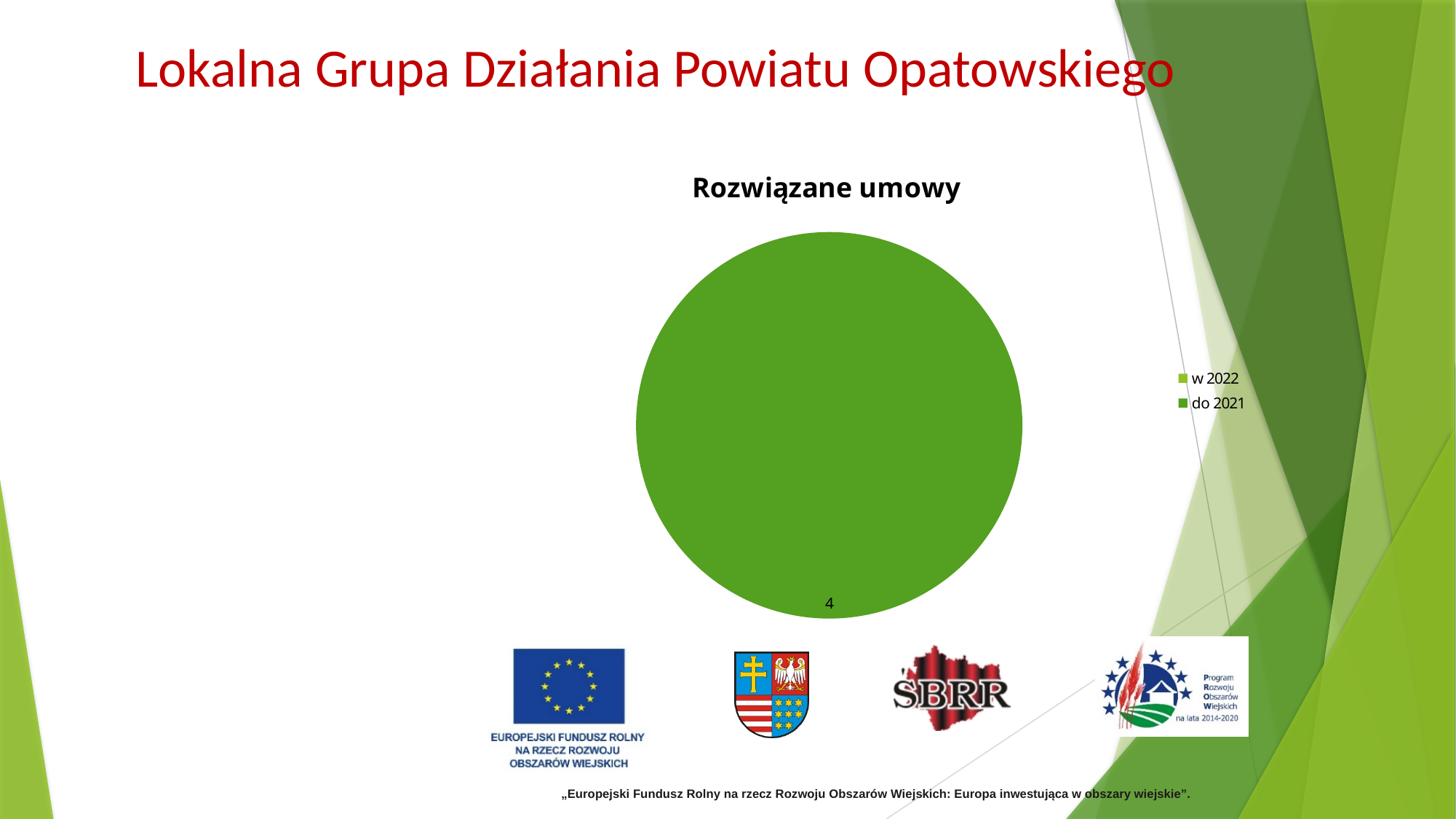
What value is printed as a data label on the pie chart? 4 How many entries does the chart legend list? 2 What kind of chart is shown on the slide? pie chart Is the value printed on the pie chart greater or less than 10? less What are the two entries listed in the chart legend? w 2022 and do 2021 What is the title of the chart? Rozwiązane umowy How many slices are visible in the pie chart? 1